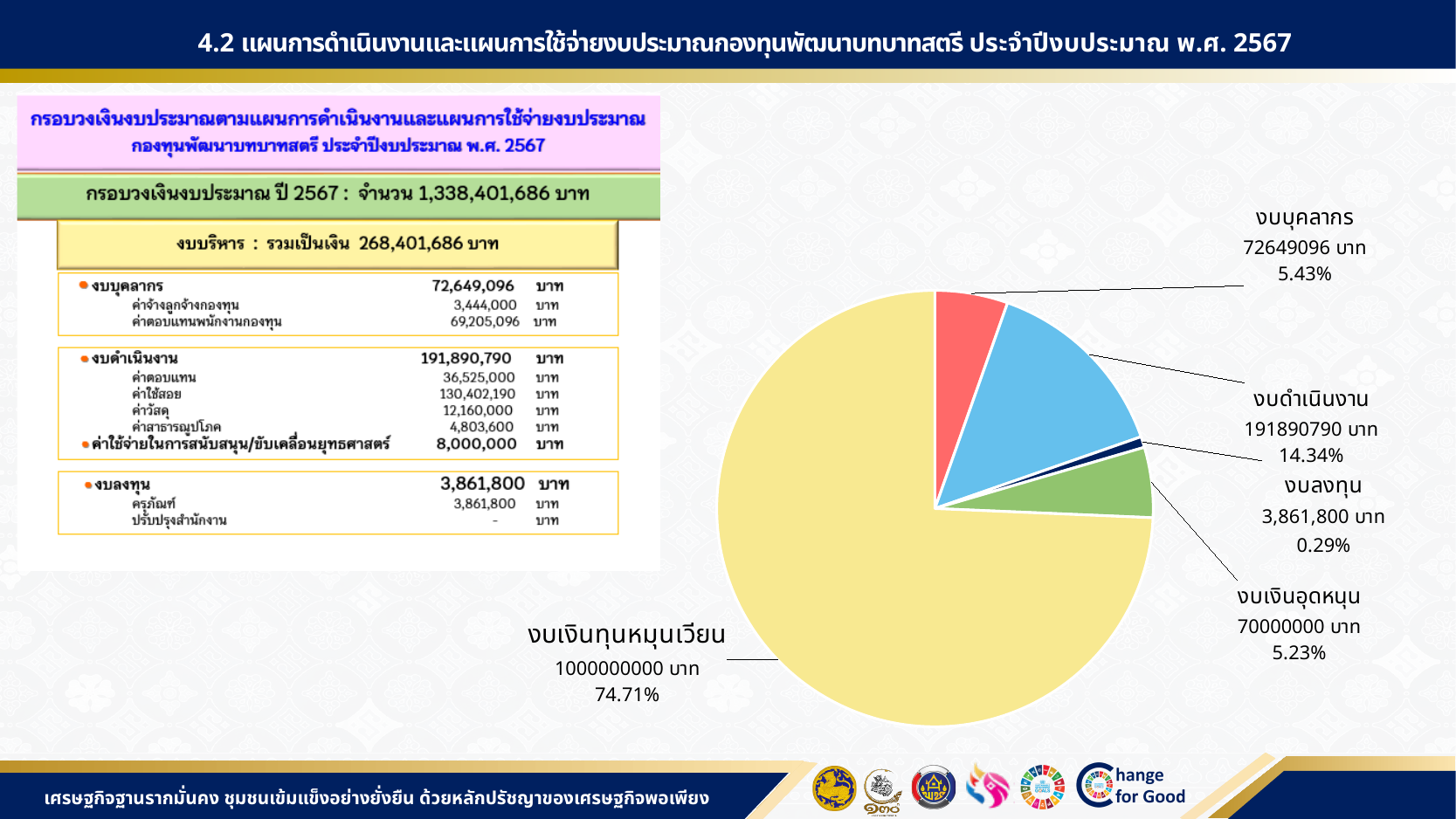
What percentage share does งบบุคลากร have in the pie chart? 5.43% Which is larger in the pie chart, งบดำเนินงาน or งบบุคลากร? งบดำเนินงาน Which slice of the pie chart is the largest? งบเงินทุนหมุนเวียน Which slice of the pie chart is the smallest? งบลงทุน What is the value shown for งบดำเนินงาน in the pie chart? 191890790 บาท What type of chart is shown on the slide? pie chart What is the value shown for งบลงทุน in the pie chart? 3,861,800 บาท What percentage share does งบเงินทุนหมุนเวียน have in the pie chart? 74.71% What is the value shown for งบเงินอุดหนุน in the pie chart? 70000000 บาท How many slices does the pie chart have? 5 What is the difference in percentage share between งบดำเนินงาน and งบบุคลากร in the pie chart? 8.91% What colour is the งบเงินทุนหมุนเวียน slice in the pie chart? yellow